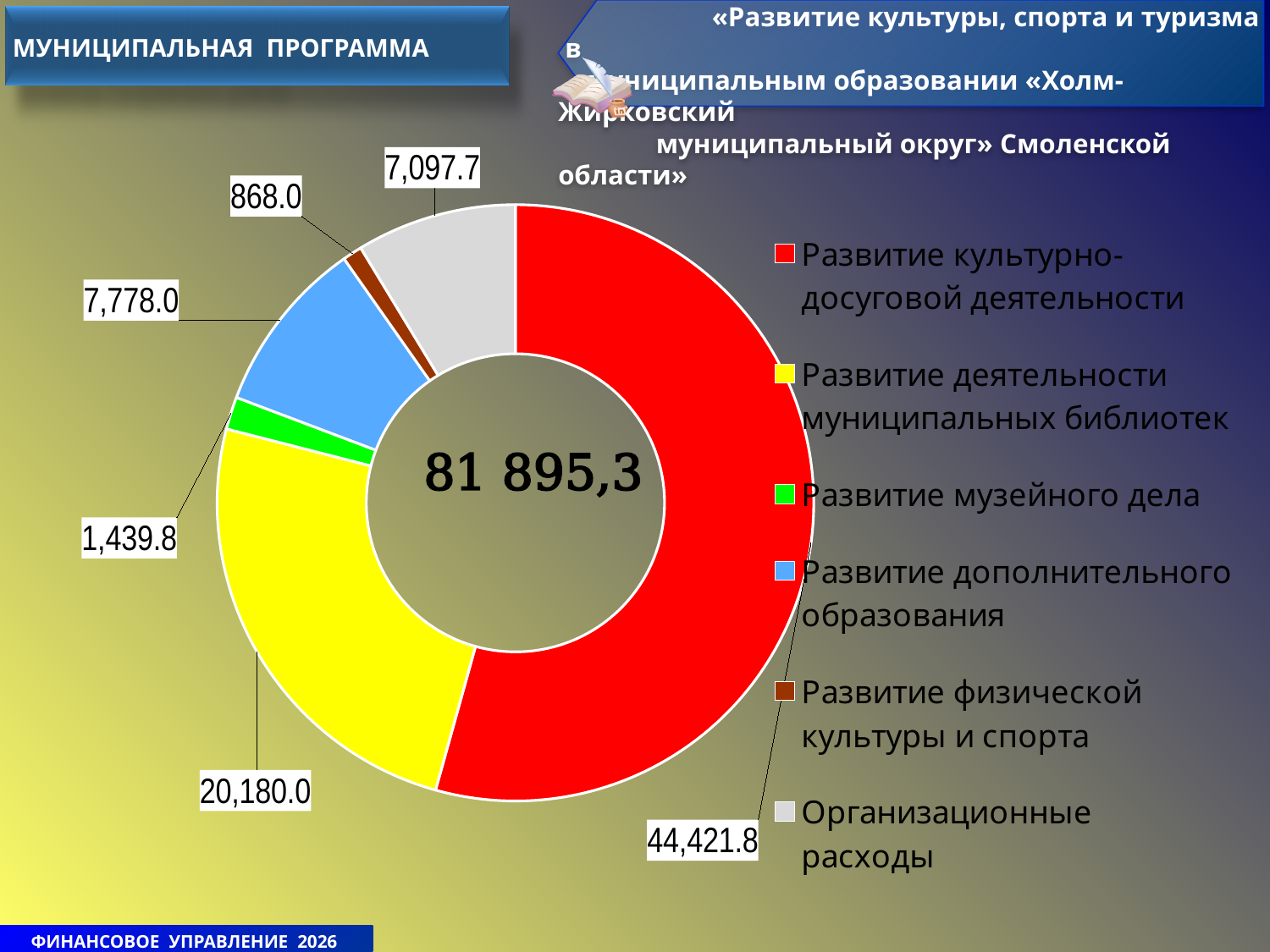
Which is larger: «Развитие дополнительного образования» or «Организационные расходы»? Развитие дополнительного образования What is the value for «Организационные расходы»? 7,097.7 Which category has the smallest slice? Развитие физической культуры и спорта What is the value for «Развитие деятельности муниципальных библиотек»? 20,180.0 What is the value for «Развитие культурно-досуговой деятельности»? 44,421.8 What number is printed in the centre of the doughnut chart? 81 895,3 What is the value for «Развитие физической культуры и спорта»? 868.0 What is the value for «Развитие музейного дела»? 1,439.8 How many categories does the chart show? 6 What is the difference between «Развитие деятельности муниципальных библиотек» and «Развитие дополнительного образования»? 12,402.0 What kind of chart is shown on the slide? Doughnut (pie) chart Which category has the largest slice? Развитие культурно-досуговой деятельности